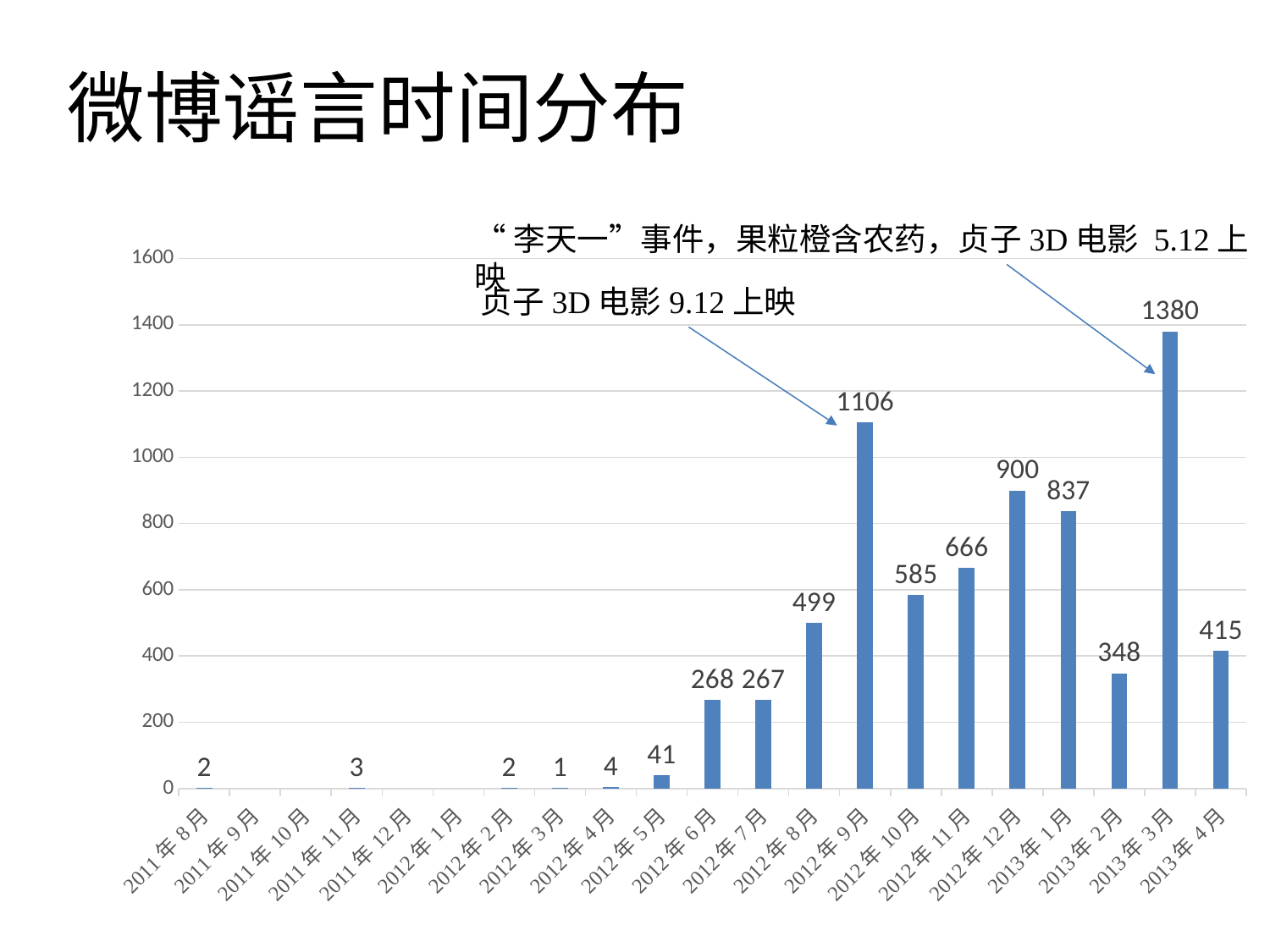
How many months are shown on the x axis? 21 What is the difference between the values for 2012年12月 and 2013年1月? 63 What is the value for 2013年3月? 1380 What kind of chart is shown on the slide? bar chart What is the value for 2012年5月? 41 Which month has the highest value? 2013年3月 Do the values rise or fall from 2012年5月 to 2012年9月? rise What is the title of the slide? 微博谣言时间分布 What is the difference between the values for 2013年3月 and 2012年9月? 274 What is the value for 2012年9月? 1106 Which is larger, the value for 2012年12月 or the value for 2012年10月? 2012年12月 What is the value for 2013年1月? 837